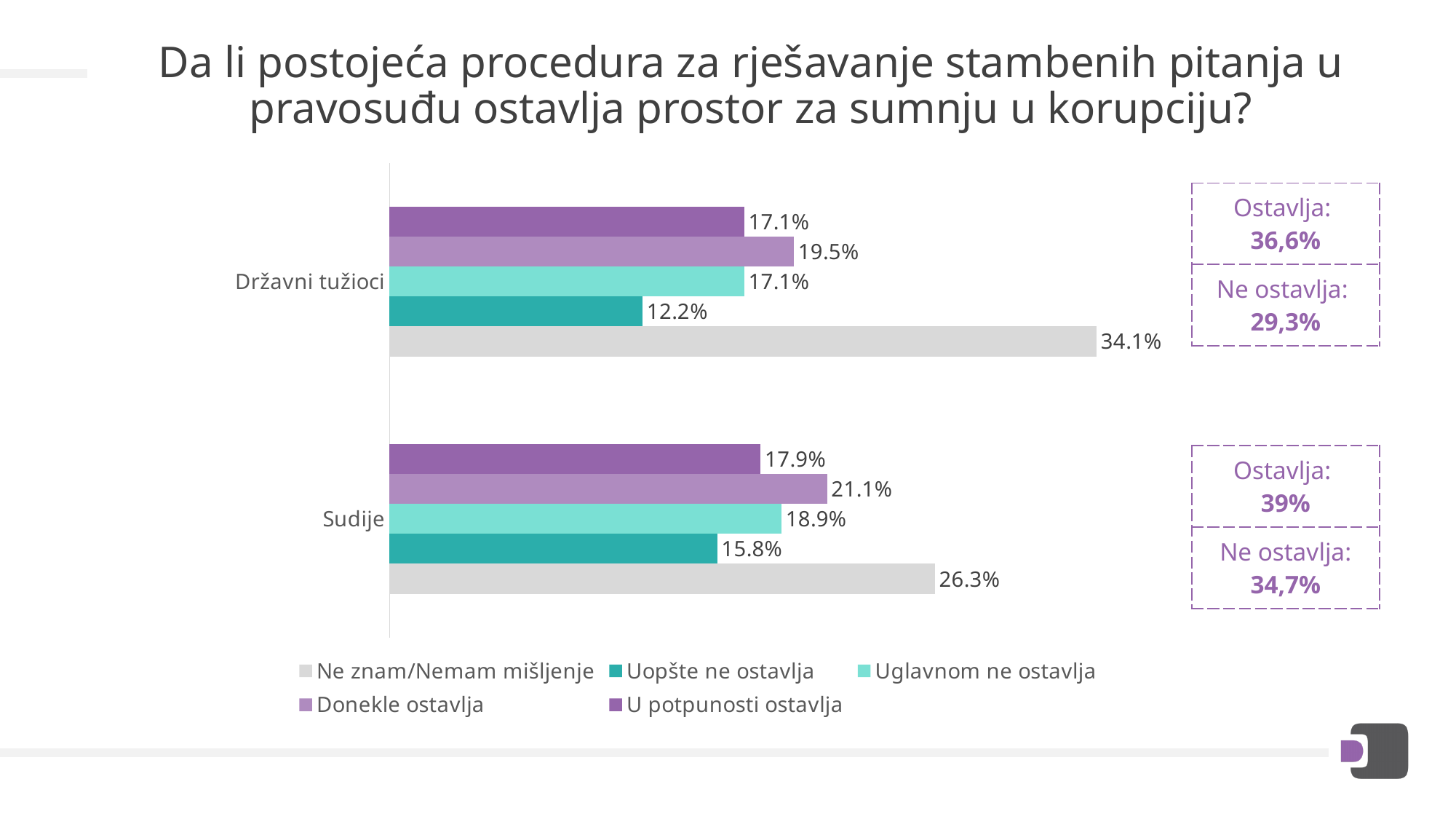
What is the difference between the "Ne znam/Nemam mišljenje" values for Državni tužioci and Sudije? 7.8% What kind of chart is shown on the slide? Bar chart Which series has the lowest value for Državni tužioci? Uopšte ne ostavlja Which series has the highest value for Sudije? Ne znam/Nemam mišljenje What total "Ostavlja" percentage is shown in the box next to the Sudije bars? 39% What is the value of "Donekle ostavlja" for Sudije? 21.1% What is the value of "Ne znam/Nemam mišljenje" for Državni tužioci? 34.1% What is the value of "Uopšte ne ostavlja" for Državni tužioci? 12.2% Which is larger: "Uglavnom ne ostavlja" for Sudije or for Državni tužioci? Sudije How many categories are shown on the chart? 2 What is the value of "U potpunosti ostavlja" for Sudije? 17.9% How many series does the legend list? 5